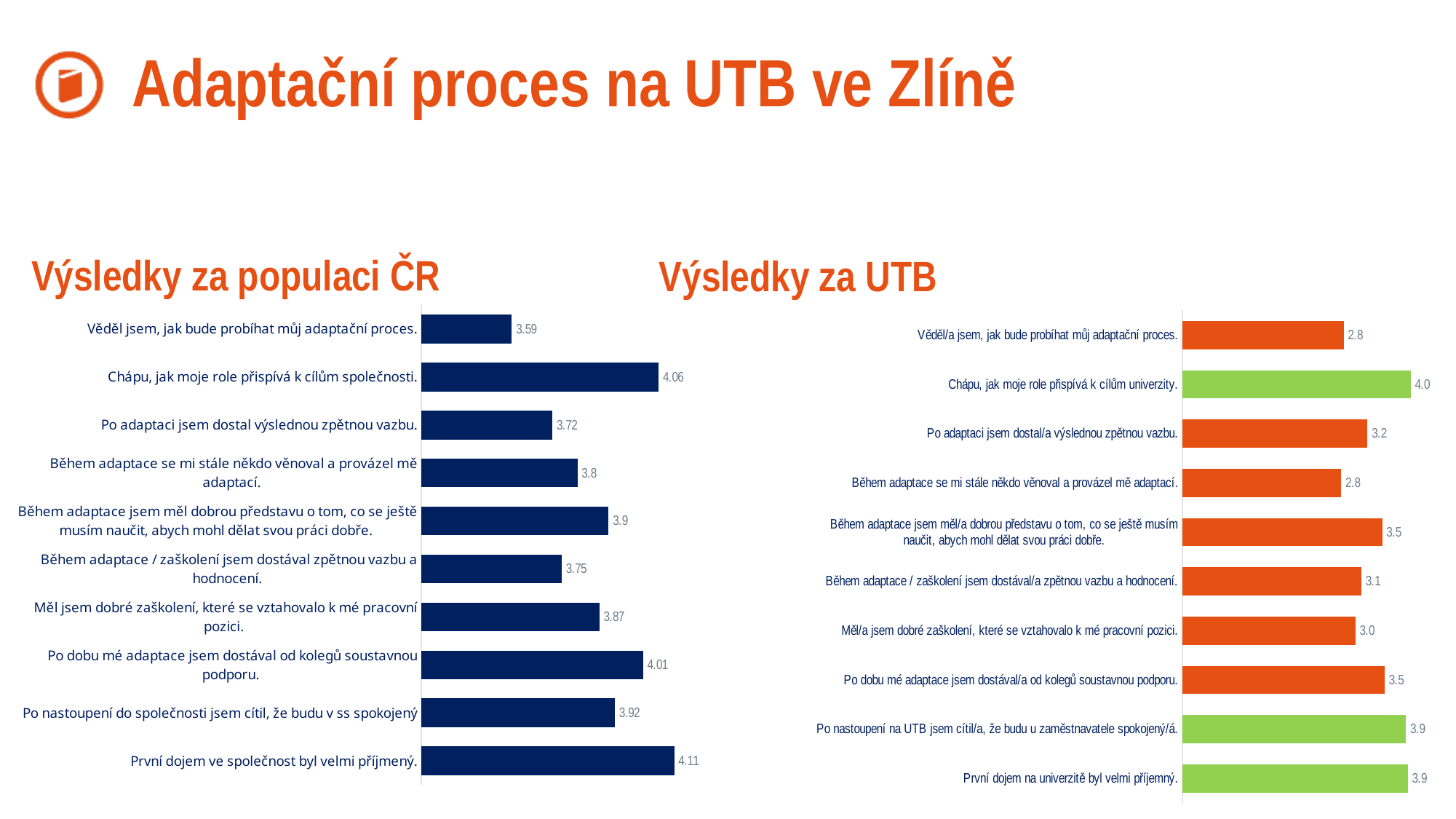
In the chart titled "Výsledky za populaci ČR", what is the difference between the values for "Chápu, jak moje role přispívá k cílům společnosti." and "Po adaptaci jsem dostal výslednou zpětnou vazbu."? 0.34 In the chart titled "Výsledky za populaci ČR", which category has the highest value? První dojem ve společnost byl velmi příjmený. In the chart titled "Výsledky za UTB", what is the difference between the values for "Chápu, jak moje role přispívá k cílům univerzity." and "Věděl/a jsem, jak bude probíhat můj adaptační proces."? 1.2 How many categories are shown in the chart titled "Výsledky za UTB"? 10 In the chart titled "Výsledky za populaci ČR", which is larger: the value for "Po dobu mé adaptace jsem dostával od kolegů soustavnou podporu." or the value for "Během adaptace / zaškolení jsem dostával zpětnou vazbu a hodnocení."? Po dobu mé adaptace jsem dostával od kolegů soustavnou podporu. In the chart titled "Výsledky za UTB", which is larger: the value for "Po dobu mé adaptace jsem dostával/a od kolegů soustavnou podporu." or the value for "Měl/a jsem dobré zaškolení, které se vztahovalo k mé pracovní pozici."? Po dobu mé adaptace jsem dostával/a od kolegů soustavnou podporu. In the chart titled "Výsledky za UTB", what colour are the bars for the three highest-valued categories? Green In the chart titled "Výsledky za populaci ČR", what is the value for "Věděl jsem, jak bude probíhat můj adaptační proces."? 3.59 In the chart titled "Výsledky za populaci ČR", which category has the lowest value? Věděl jsem, jak bude probíhat můj adaptační proces. In the chart titled "Výsledky za UTB", which category has the highest value? Chápu, jak moje role přispívá k cílům univerzity. What kind of chart is the chart titled "Výsledky za populaci ČR"? Bar chart In the chart titled "Výsledky za UTB", what is the value for "Po adaptaci jsem dostal/a výslednou zpětnou vazbu."? 3.2